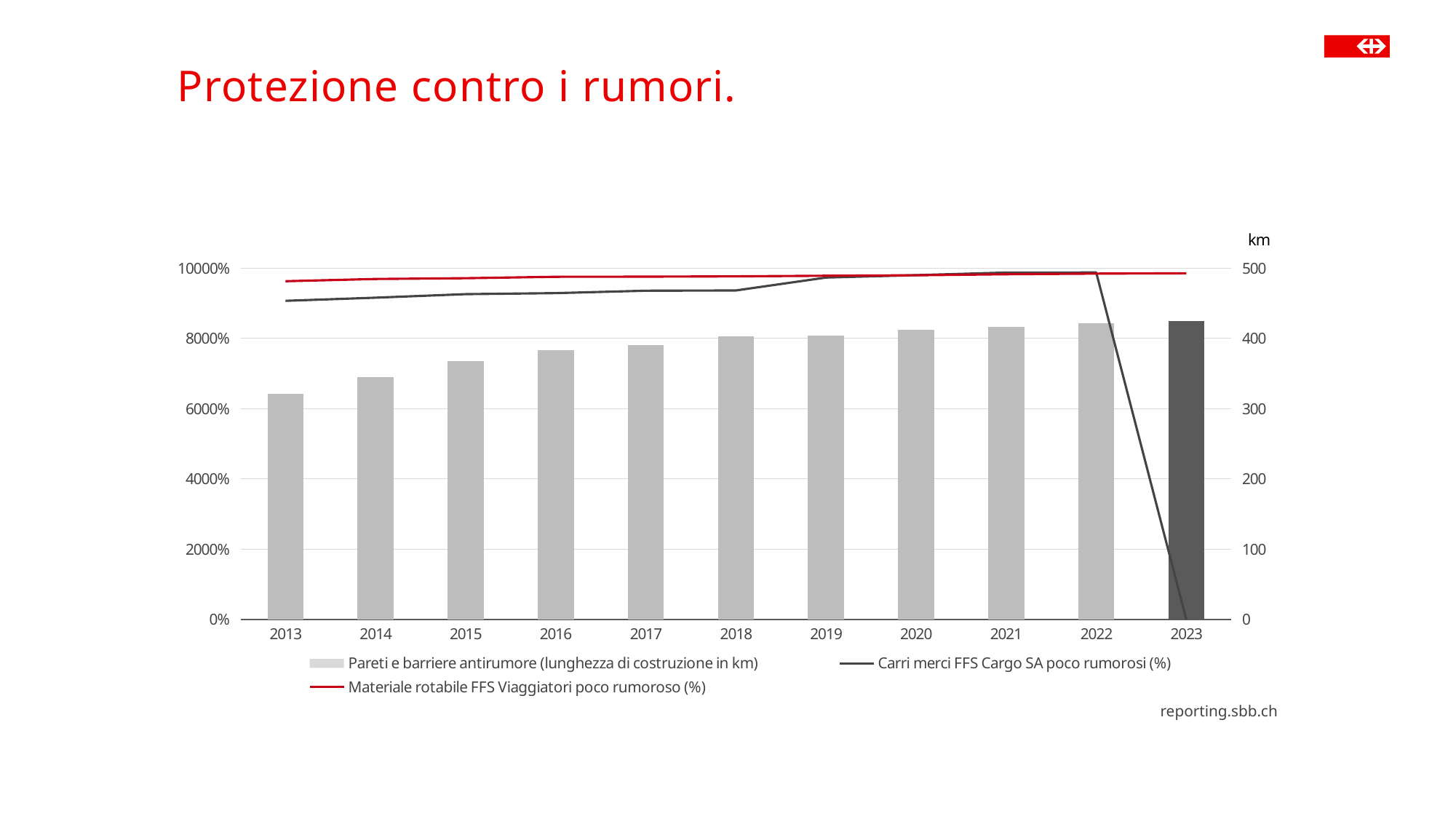
How many series does the chart legend list? 3 Which year has the shortest bar for Pareti e barriere antirumore? 2013 How many years are shown on the x axis of the chart? 11 In 2013, which line is higher: Materiale rotabile FFS Viaggiatori poco rumoroso or Carri merci FFS Cargo SA poco rumorosi? Materiale rotabile FFS Viaggiatori poco rumoroso What colour is the line for Materiale rotabile FFS Viaggiatori poco rumoroso (%)? Red Which year has the tallest bar for Pareti e barriere antirumore? 2023 Do the bars for Pareti e barriere antirumore rise or fall from 2013 to 2023? Rise Is the bar value for Pareti e barriere antirumore in 2013 greater or less than 300 km? greater Is the bar value for Pareti e barriere antirumore in 2023 greater or less than 400 km? greater What kind of chart is shown on the slide? A combined bar and line chart Is the bar value for Pareti e barriere antirumore in 2015 greater or less than 400 km? less What unit is shown at the top of the right-hand axis? km